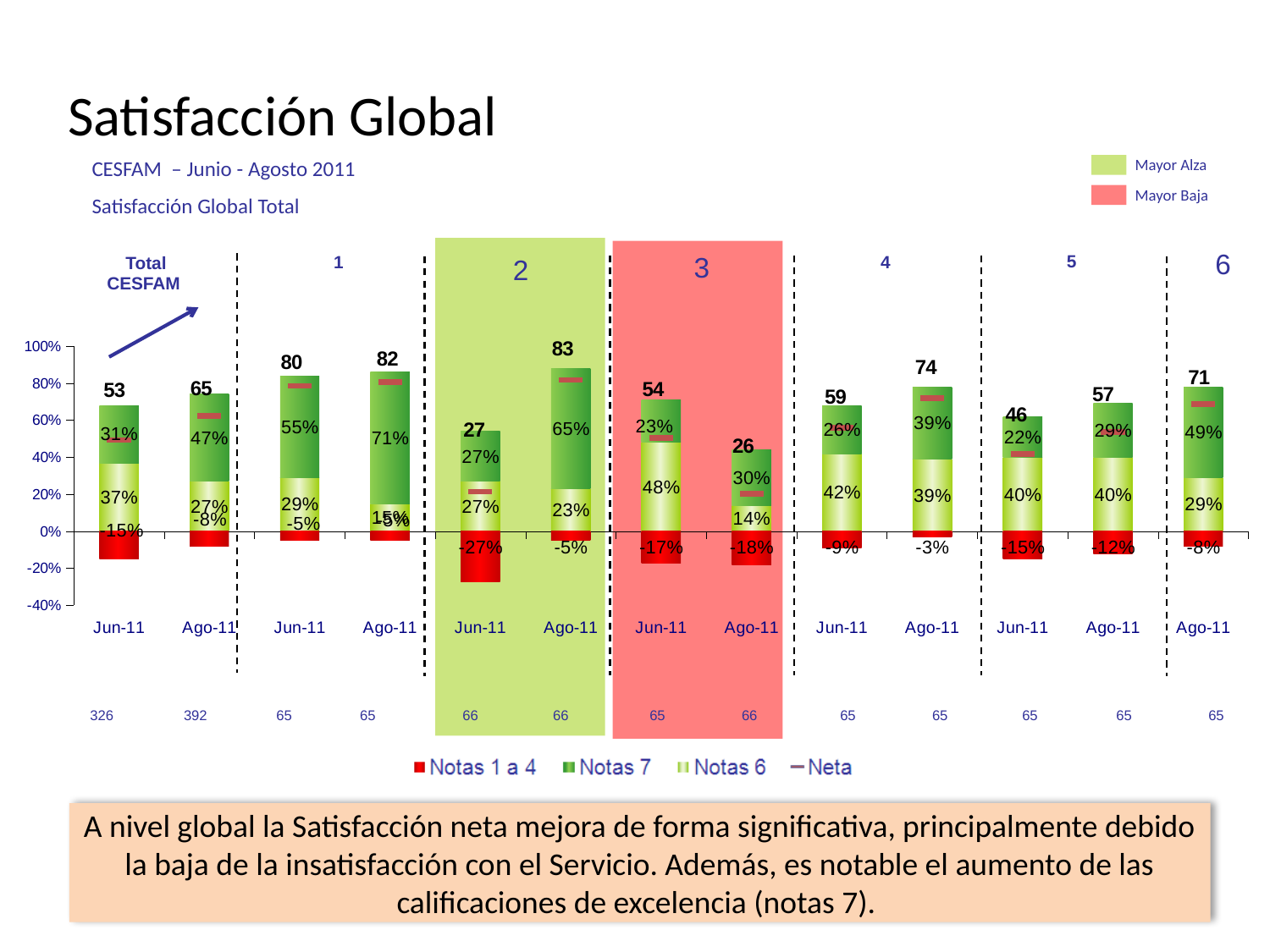
How many bars are plotted in the chart? 13 What is the Neta value for group 6 in Ago-11? 71 Which bar has the highest Neta value? Group 2, Ago-11 (83) How many series does the chart legend list? 4 What is the Neta value for Total CESFAM in Ago-11? 65 What is the Notas 6 percentage for group 3 in Jun-11? 48% For group 4, which month has the larger Notas 7 percentage, Jun-11 or Ago-11? Ago-11 What is the Notas 7 percentage for group 1 in Ago-11? 71% By how much did the Neta value for Total CESFAM increase from Jun-11 to Ago-11? 12 What kind of chart is shown on the slide? Stacked bar chart What is the Notas 1 a 4 percentage for group 2 in Jun-11? -27% Which bar has the lowest Neta value? Group 3, Ago-11 (26)